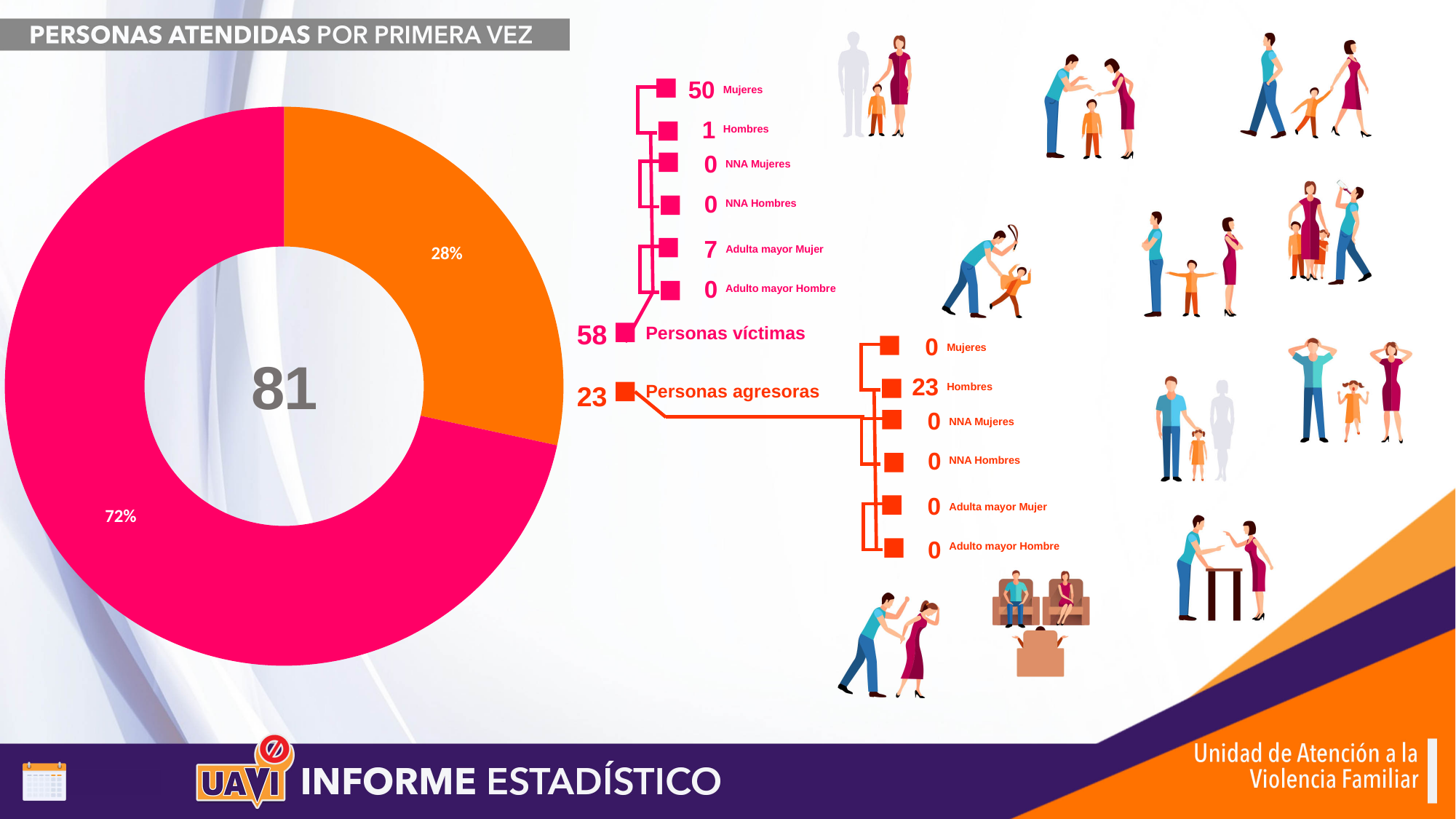
How many slices does the donut chart have? 2 What is the difference in percentage points between the two slices of the donut chart? 44 How many Personas víctimas are reported on the slide? 58 Which slice of the donut chart is larger, the pink one or the orange one? The pink one What number is printed in the centre of the donut chart? 81 In the Personas agresoras breakdown, how many Hombres are listed? 23 What percentage does the pink slice of the donut chart show? 72% What kind of chart is shown on the slide? Donut (pie) chart In the Personas víctimas breakdown, how many Mujeres are listed? 50 What percentage does the orange slice of the donut chart show? 28% What is the title of the slide? PERSONAS ATENDIDAS POR PRIMERA VEZ How many Personas agresoras are reported on the slide? 23